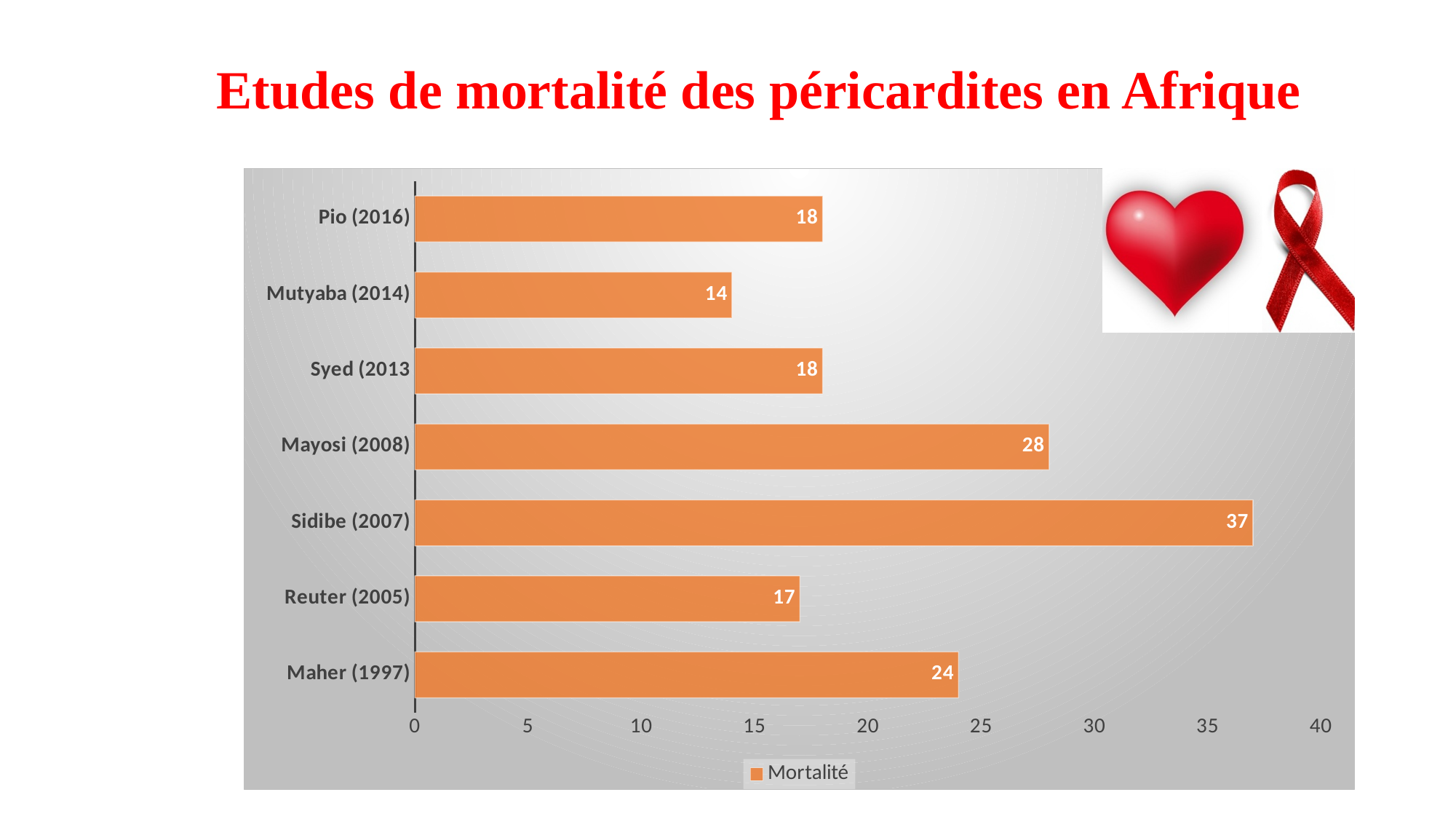
What is the difference between the Mortalité values for Sidibe (2007) and Mayosi (2008)? 9 What is the Mortalité value for Maher (1997)? 24 What is the Mortalité value for Sidibe (2007)? 37 Is the Mortalité value for Mayosi (2008) greater or less than 25? greater How many series does the legend list? 1 What is the Mortalité value for Mutyaba (2014)? 14 How many studies are shown in the chart? 7 What is the name of the series shown in the legend? Mortalité Which study has the lowest Mortalité value? Mutyaba (2014) Which study has the highest Mortalité value? Sidibe (2007) Which has a larger Mortalité value, Maher (1997) or Reuter (2005)? Maher (1997) What kind of chart is shown on the slide? Bar chart